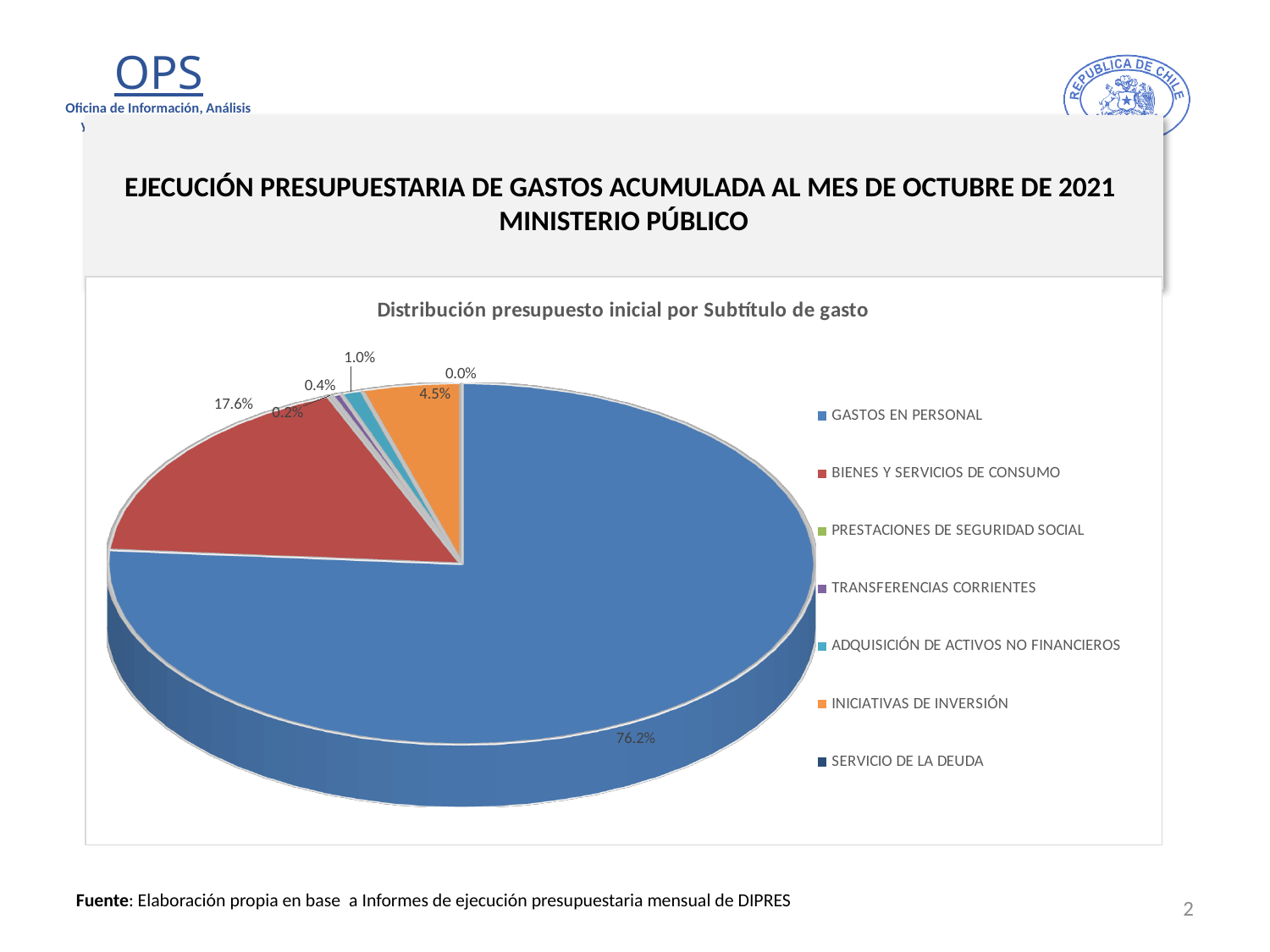
What percentage is shown for SERVICIO DE LA DEUDA? 0.0% What percentage is shown for ADQUISICIÓN DE ACTIVOS NO FINANCIEROS? 1.0% What percentage is shown for INICIATIVAS DE INVERSIÓN? 4.5% What is the title of the chart? Distribución presupuesto inicial por Subtítulo de gasto How many categories does the legend list? 7 What percentage is shown for BIENES Y SERVICIOS DE CONSUMO? 17.6% Which is larger, the share for BIENES Y SERVICIOS DE CONSUMO or the share for INICIATIVAS DE INVERSIÓN? BIENES Y SERVICIOS DE CONSUMO What is the difference in percentage points between GASTOS EN PERSONAL and BIENES Y SERVICIOS DE CONSUMO? 58.6 What share of the pie does GASTOS EN PERSONAL represent? 76.2% Which category has the smallest share of the pie? SERVICIO DE LA DEUDA Which category has the largest share of the pie? GASTOS EN PERSONAL What kind of chart is shown on the slide? Pie chart